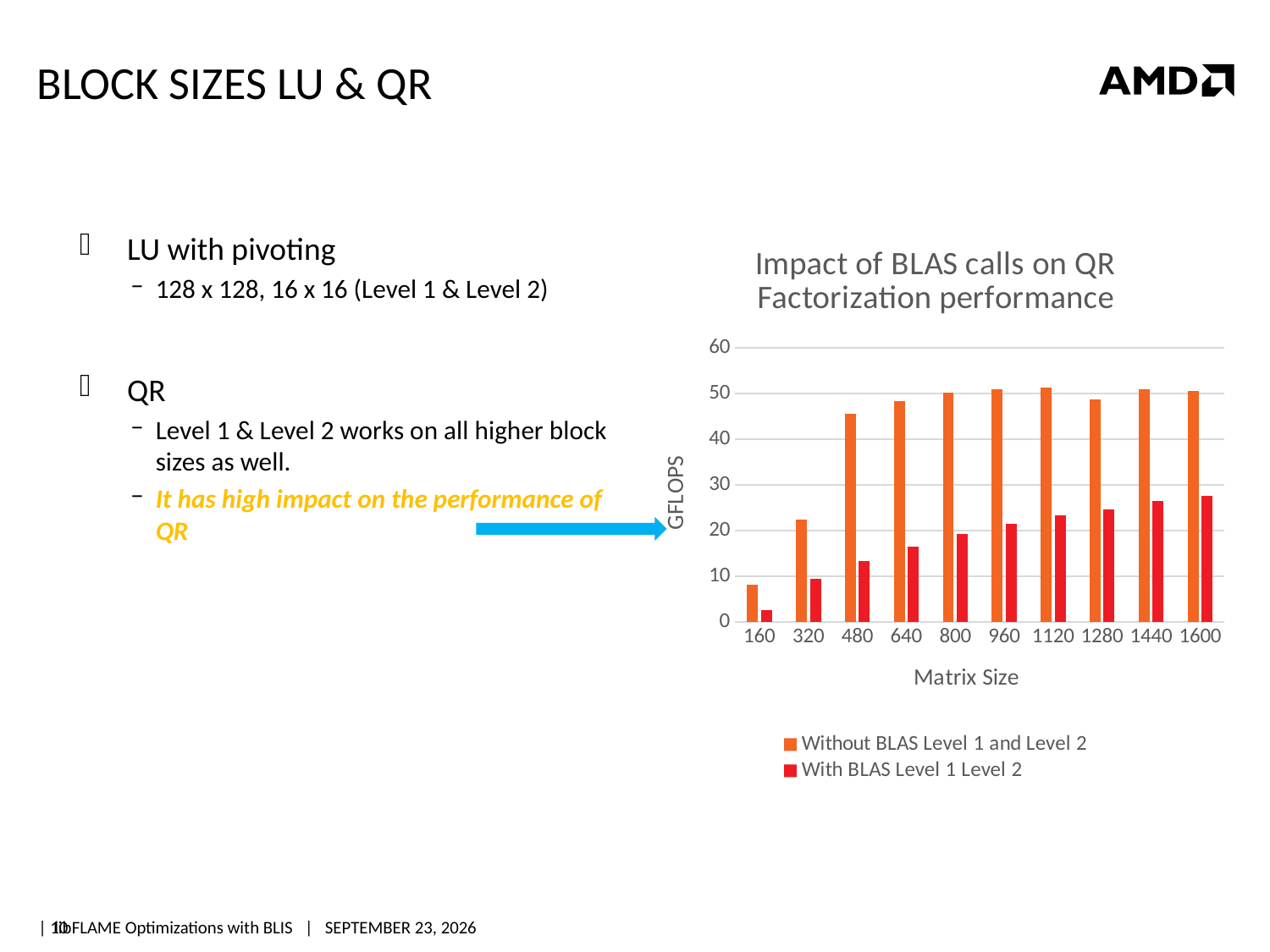
What is the label of the y axis of the chart? GFLOPS At matrix size 960, which series has the larger value: 'Without BLAS Level 1 and Level 2' or 'With BLAS Level 1 Level 2'? Without BLAS Level 1 and Level 2 How many series does the chart legend list? 2 Is the value for 'Without BLAS Level 1 and Level 2' at matrix size 480 greater or less than 40? greater How many matrix sizes are shown on the x axis of the chart? 10 Which matrix size has the lowest value for 'With BLAS Level 1 Level 2'? 160 Is the value for 'With BLAS Level 1 Level 2' at matrix size 1120 greater or less than 20? greater Is the value for 'Without BLAS Level 1 and Level 2' at matrix size 160 greater or less than 10? less What is the title of the chart? Impact of BLAS calls on QR Factorization performance What kind of chart is shown on the slide? bar chart Which matrix size has the highest value for 'With BLAS Level 1 Level 2'? 1600